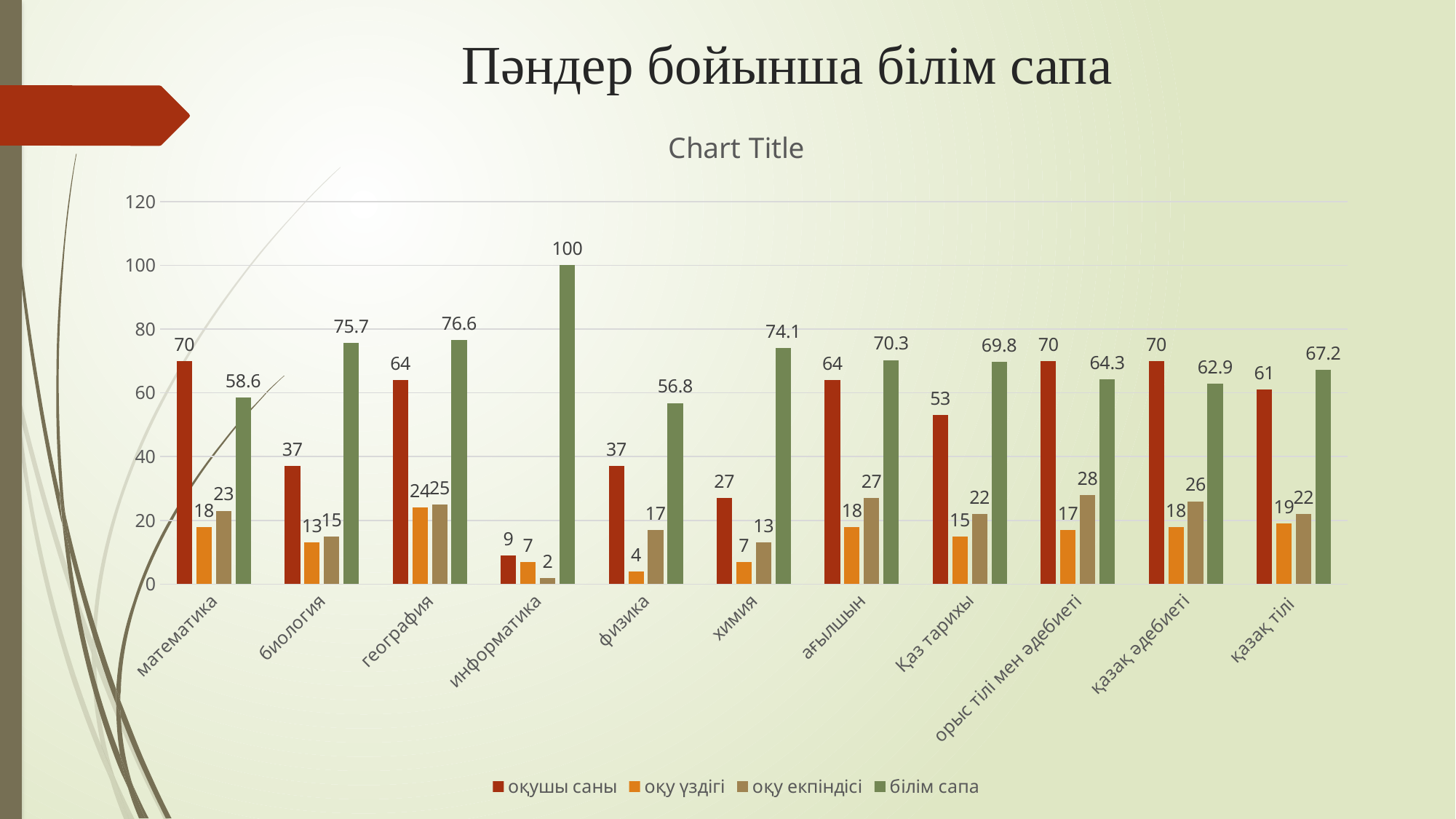
What kind of chart is shown on the slide? bar chart What is the value of оқу екпіндісі for орыс тілі мен әдебиеті? 28 How many categories are shown on the x axis? 11 What is the value of білім сапа for информатика? 100 How many series does the legend list? 4 Which is larger: оқушы саны for химия or оқушы саны for Қаз тарихы? Қаз тарихы What is the value of оқу үздігі for физика? 4 Is the білім сапа value for биология greater or less than 60? greater What is the value of оқушы саны for география? 64 What is the difference between the білім сапа values for география and математика? 18 Which category has the lowest білім сапа value? физика Which category has the highest білім сапа value? информатика